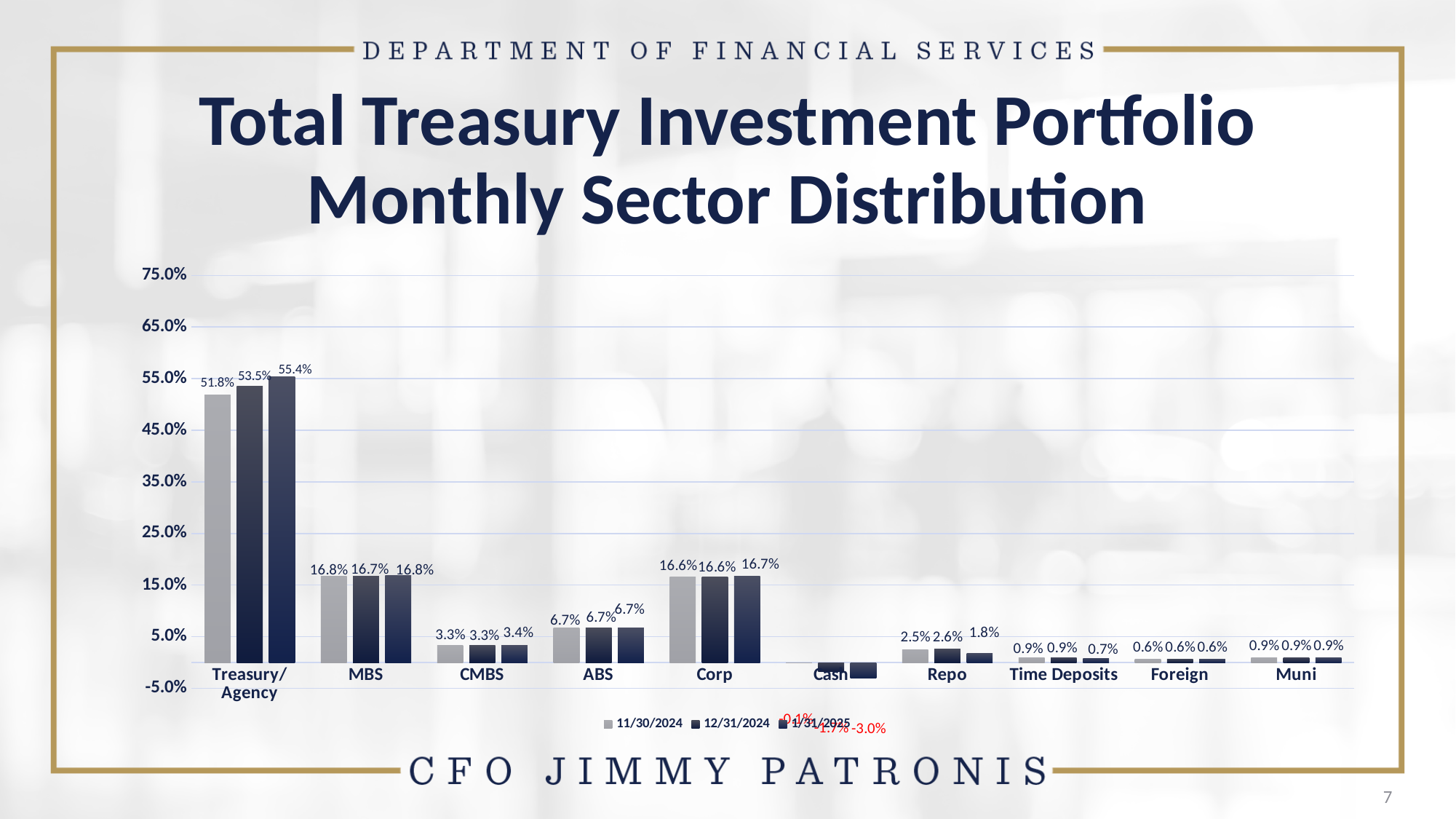
What kind of chart is shown on the slide? bar chart Do the Treasury/Agency values rise or fall from 11/30/2024 to 1/31/2025? rise How many sector categories are shown on the x axis? 10 What is the value for MBS for 11/30/2024? 16.8% What is the value for Corp for 12/31/2024? 16.6% Which is larger for 12/31/2024: the value for MBS or the value for ABS? MBS How many series does the legend list? 3 Which sector has the highest value for 1/31/2025? Treasury/Agency What is the difference between the Treasury/Agency values for 1/31/2025 and 11/30/2024? 3.6% What is the value for Treasury/Agency for 1/31/2025? 55.4% What is the title of the chart? Total Treasury Investment Portfolio Monthly Sector Distribution What is the value for Repo for 1/31/2025? 1.8%